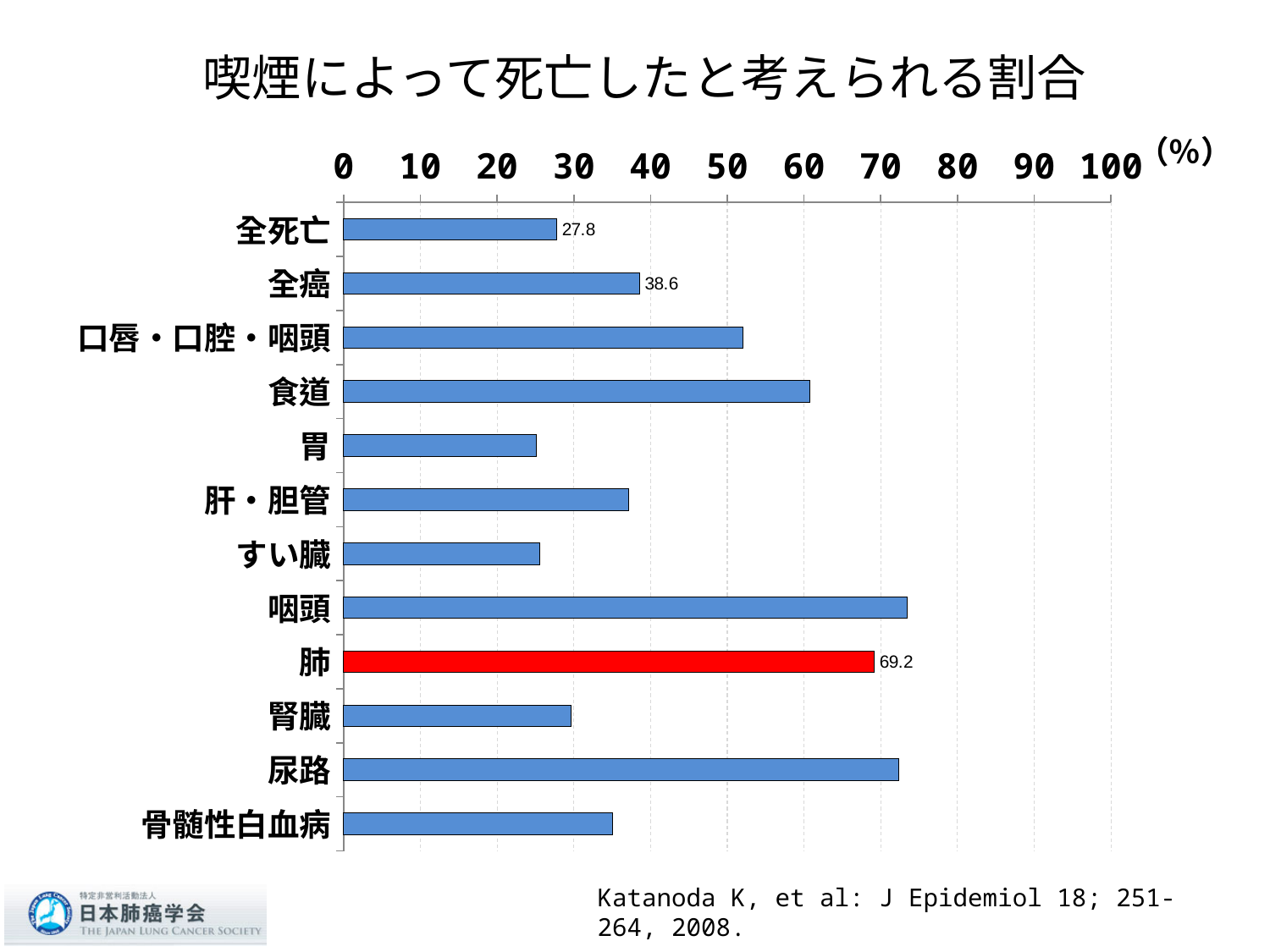
Is the value for 食道 greater or less than 50? greater What is the value for 肺? 69.2 What is the difference between the values for 全癌 and 全死亡? 10.8 How many categories are shown in the chart? 12 What is the value for 全癌? 38.6 Which is larger, the value for 咽頭 or the value for 胃? 咽頭 Is the value for 骨髄性白血病 greater or less than 40? less Is the value for 胃 greater or less than 30? less What is the value for 全死亡? 27.8 Which is larger, the value for 肺 or the value for 全癌? 肺 What is the difference between the values for 肺 and 全癌? 30.6 What kind of chart is shown on the slide? bar chart